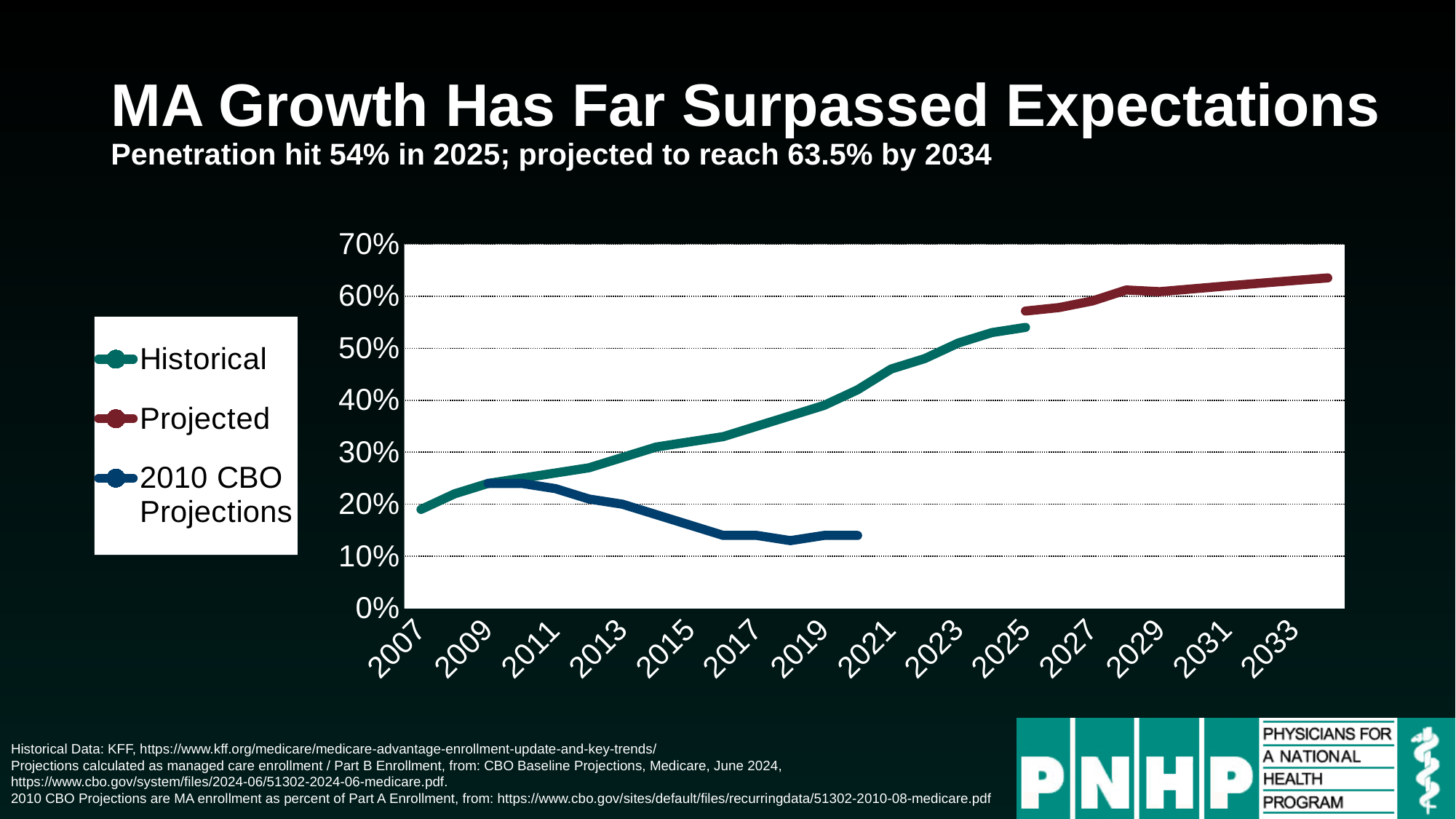
Is the 2010 CBO Projections value for 2019 greater or less than 20%? less What was the MA penetration value for the Historical series in 2025? 54% What value is the Projected series expected to reach by 2034? 63.5% Does the Historical series rise or fall from 2007 to 2025? rise What colour is the line for the Projected series? dark red Does the 2010 CBO Projections series rise or fall from 2009 to 2020? fall In 2019, which series has the larger value: Historical or 2010 CBO Projections? Historical Is the Projected value for 2027 greater or less than 50%? greater What is the difference between the projected 2034 value (63.5%) and the 2025 historical value (54%)? 9.5% What kind of chart is shown on the slide? line chart How many series does the legend list? 3